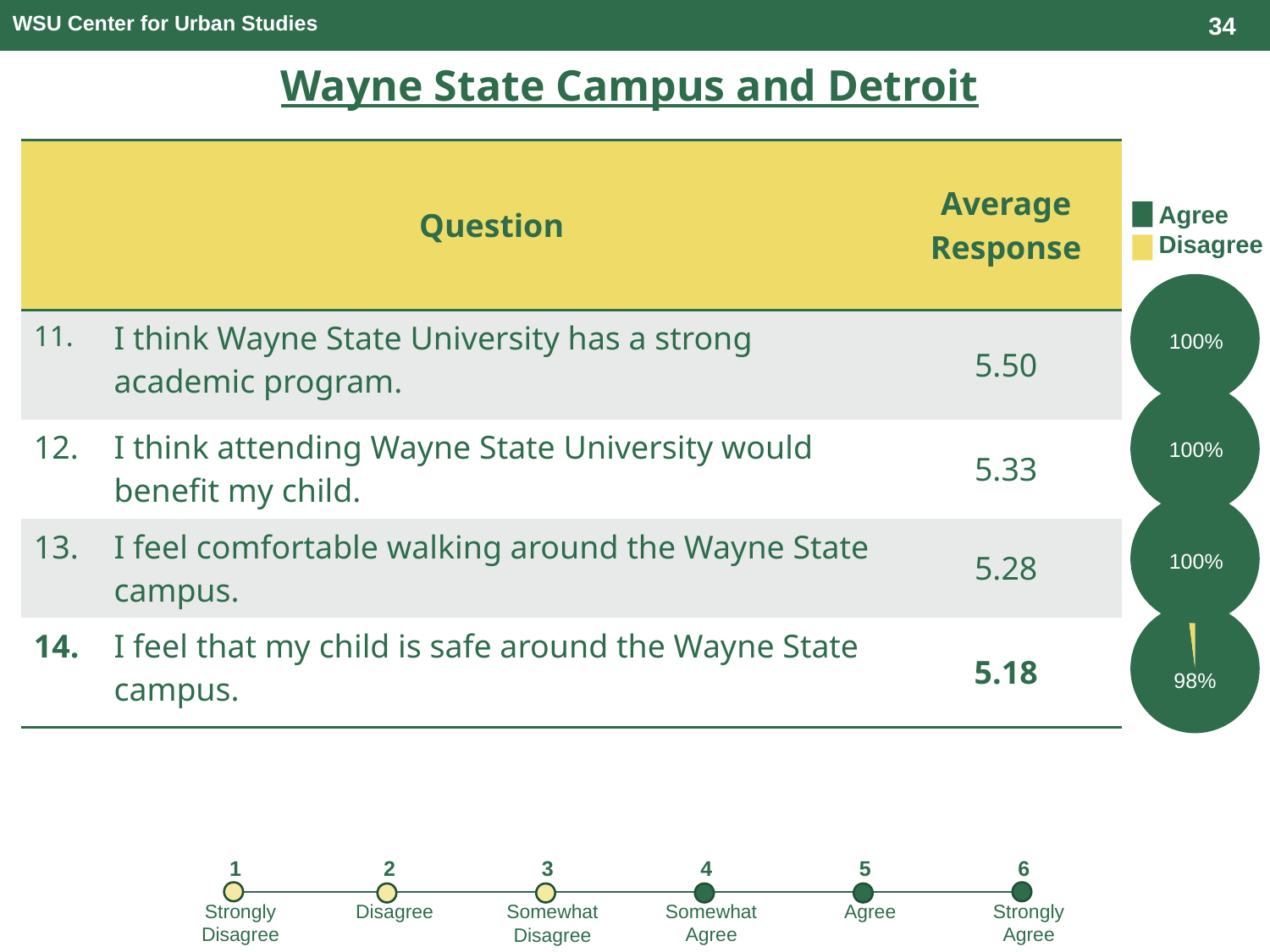
In the pie chart for question 12 (attending would benefit my child), what percentage is labelled? 100% How many pie charts are shown on the slide? 4 What is the difference between the Agree percentage in the pie chart for question 11 and the Agree percentage in the pie chart for question 14? 2% How many series does the legend for the pie charts list? 2 In the pie chart for question 14 (my child is safe around campus), what percentage is labelled for Agree? 98% In the pie chart for question 13 (comfortable walking around campus), what percentage is labelled? 100% In the pie chart for question 11 (strong academic program), what percentage is labelled? 100% Which question's pie chart shows the lowest Agree percentage? Question 14 What kind of charts are shown next to the table rows on the slide? Pie charts What are the two entries in the legend for the pie charts? Agree and Disagree In the pie chart legend, which colour represents Agree? Green Which pie chart shows a larger Agree percentage, the one for question 13 or the one for question 14? Question 13